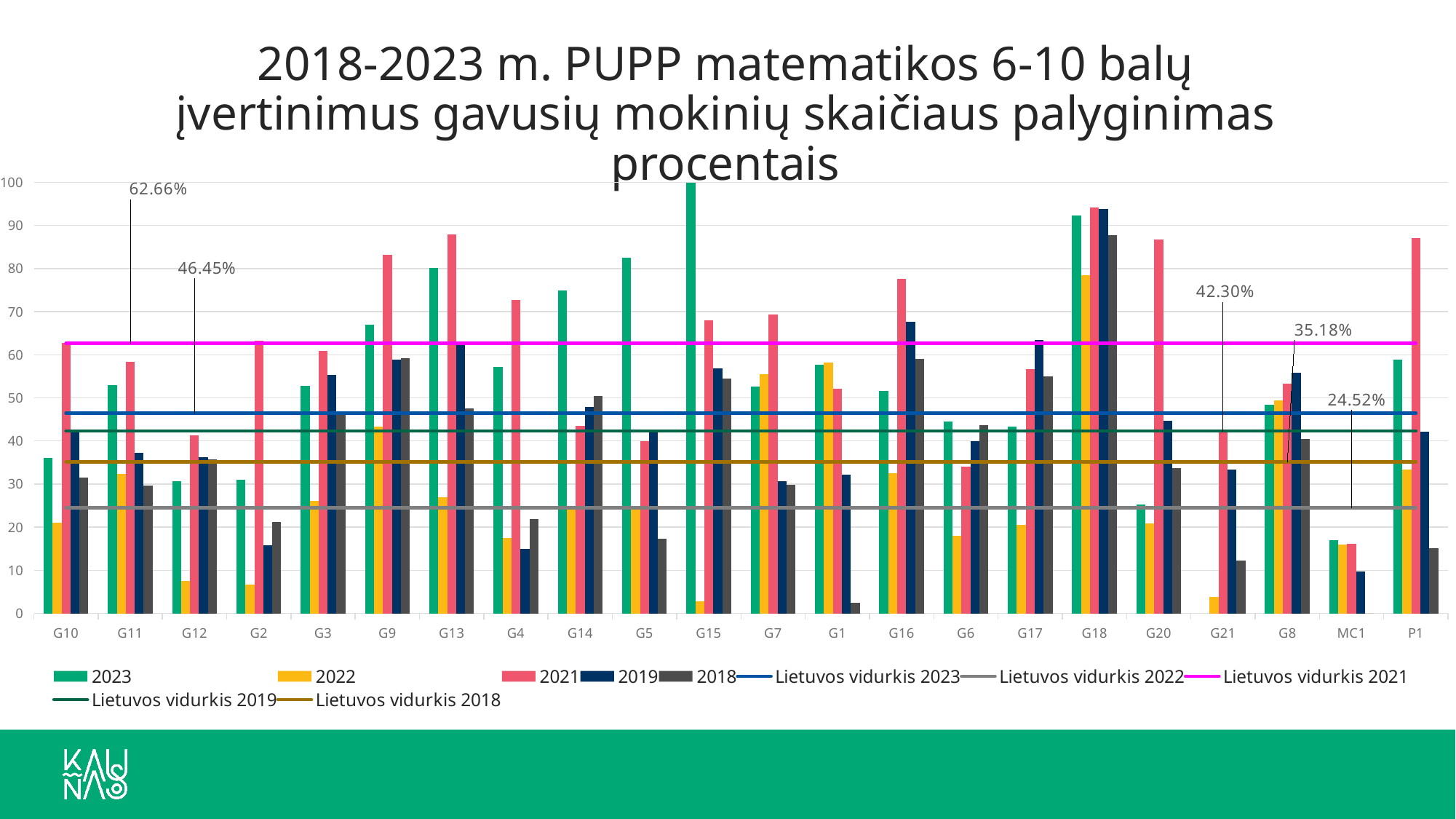
What is the value of the Lietuvos vidurkis 2021 line? 62.66% What is the difference between the Lietuvos vidurkis 2021 line and the Lietuvos vidurkis 2022 line? 38.14% What kind of chart is shown on the slide? combination bar and line chart What is the value of the Lietuvos vidurkis 2018 line? 35.18% Is the 2021 value for G18 greater or less than 90? greater What is the value of the Lietuvos vidurkis 2023 line? 46.45% Which category has the lowest 2023 bar? MC1 What is the value of the Lietuvos vidurkis 2019 line? 42.30% Which category has the highest 2023 bar? G15 What is the value of the Lietuvos vidurkis 2022 line? 24.52% How many categories are shown along the x axis? 22 How many series does the legend list? 10